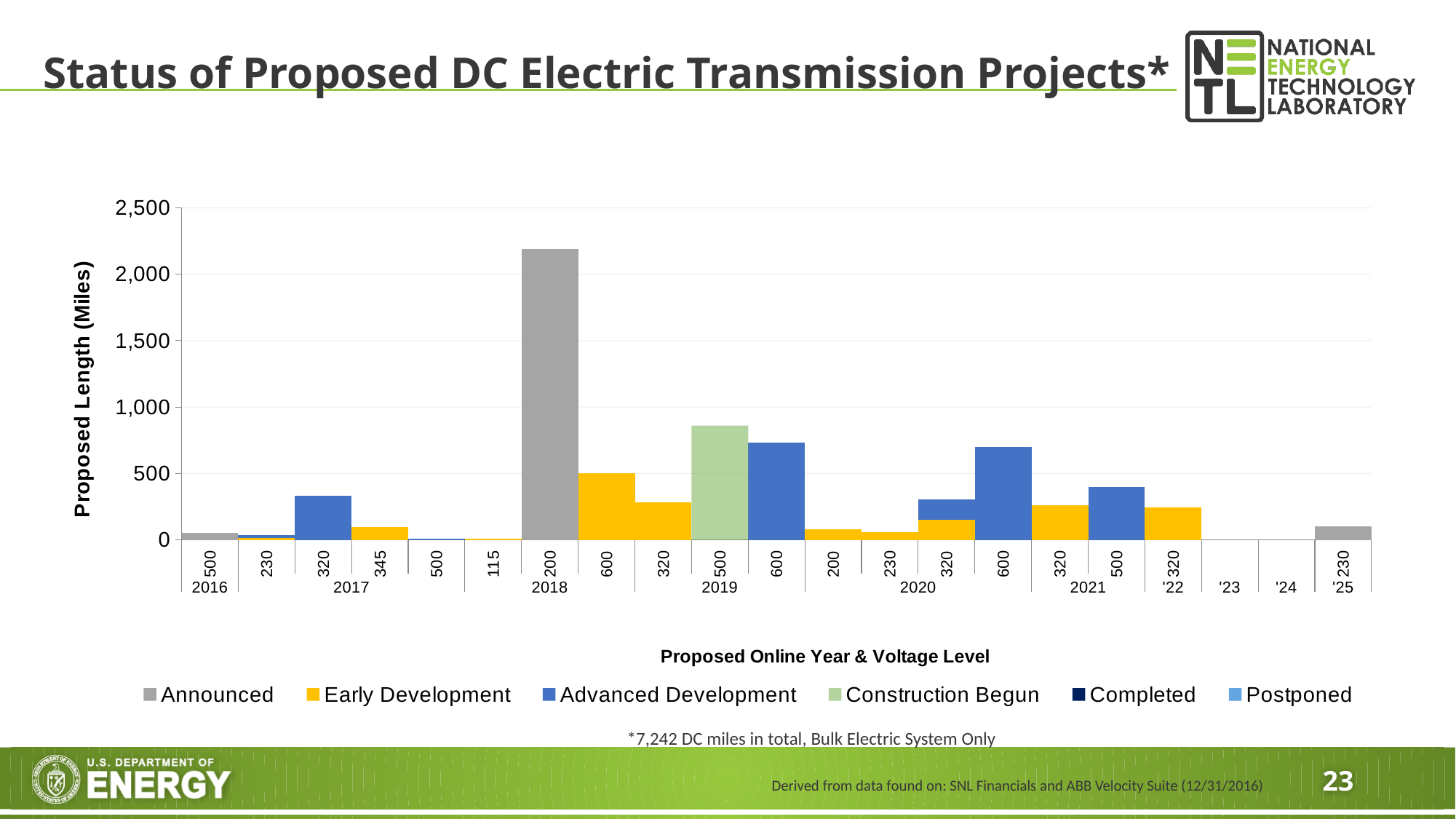
Which status series does the tallest bar (2018, 200 kV) belong to? Announced How many series does the legend list? 6 Is the proposed length for the 2019, 500 kV bar greater or less than 500 miles? greater Which is larger: the proposed length for 2019 at 500 kV or 2019 at 600 kV? 2019 at 500 kV Is the proposed length for the 2018, 200 kV bar greater or less than 2,000 miles? greater How many years are labeled along the x axis? 10 Which year and voltage level has the highest proposed length? 2018, 200 Which is larger: the proposed length for 2020 at 600 kV or 2021 at 500 kV? 2020 at 600 kV Is the proposed length for the 2019, 600 kV bar greater or less than 1,000 miles? less Which status series is the 2019, 500 kV bar plotted in? Construction Begun What kind of chart is shown on the slide? Bar chart